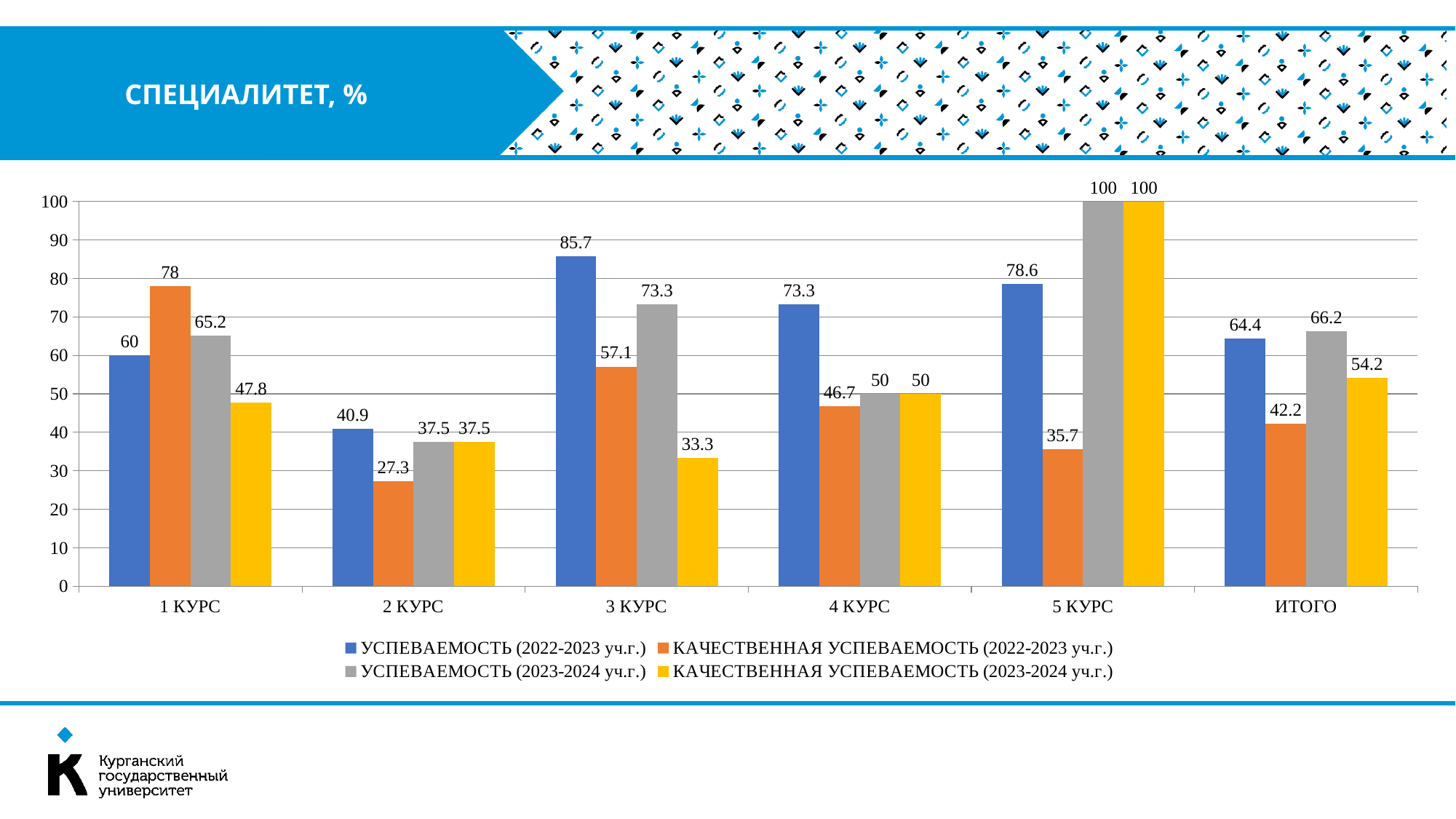
Is the value of КАЧЕСТВЕННАЯ УСПЕВАЕМОСТЬ (2023-2024 уч.г.) for 3 КУРС greater or less than 40? less Which category has the highest value for УСПЕВАЕМОСТЬ (2023-2024 уч.г.)? 5 КУРС What is the value of КАЧЕСТВЕННАЯ УСПЕВАЕМОСТЬ (2023-2024 уч.г.) for ИТОГО? 54.2 What is the value of УСПЕВАЕМОСТЬ (2022-2023 уч.г.) for 3 КУРС? 85.7 What is the title of the slide? СПЕЦИАЛИТЕТ, % What is the difference between УСПЕВАЕМОСТЬ (2022-2023 уч.г.) and КАЧЕСТВЕННАЯ УСПЕВАЕМОСТЬ (2022-2023 уч.г.) for 1 КУРС? 18 For 4 КУРС, which is larger: УСПЕВАЕМОСТЬ (2022-2023 уч.г.) or УСПЕВАЕМОСТЬ (2023-2024 уч.г.)? УСПЕВАЕМОСТЬ (2022-2023 уч.г.) What kind of chart is shown on the slide? bar chart Which category has the lowest value for КАЧЕСТВЕННАЯ УСПЕВАЕМОСТЬ (2022-2023 уч.г.)? 2 КУРС What is the value of КАЧЕСТВЕННАЯ УСПЕВАЕМОСТЬ (2022-2023 уч.г.) for 5 КУРС? 35.7 How many categories are shown on the x axis? 6 How many series does the legend list? 4